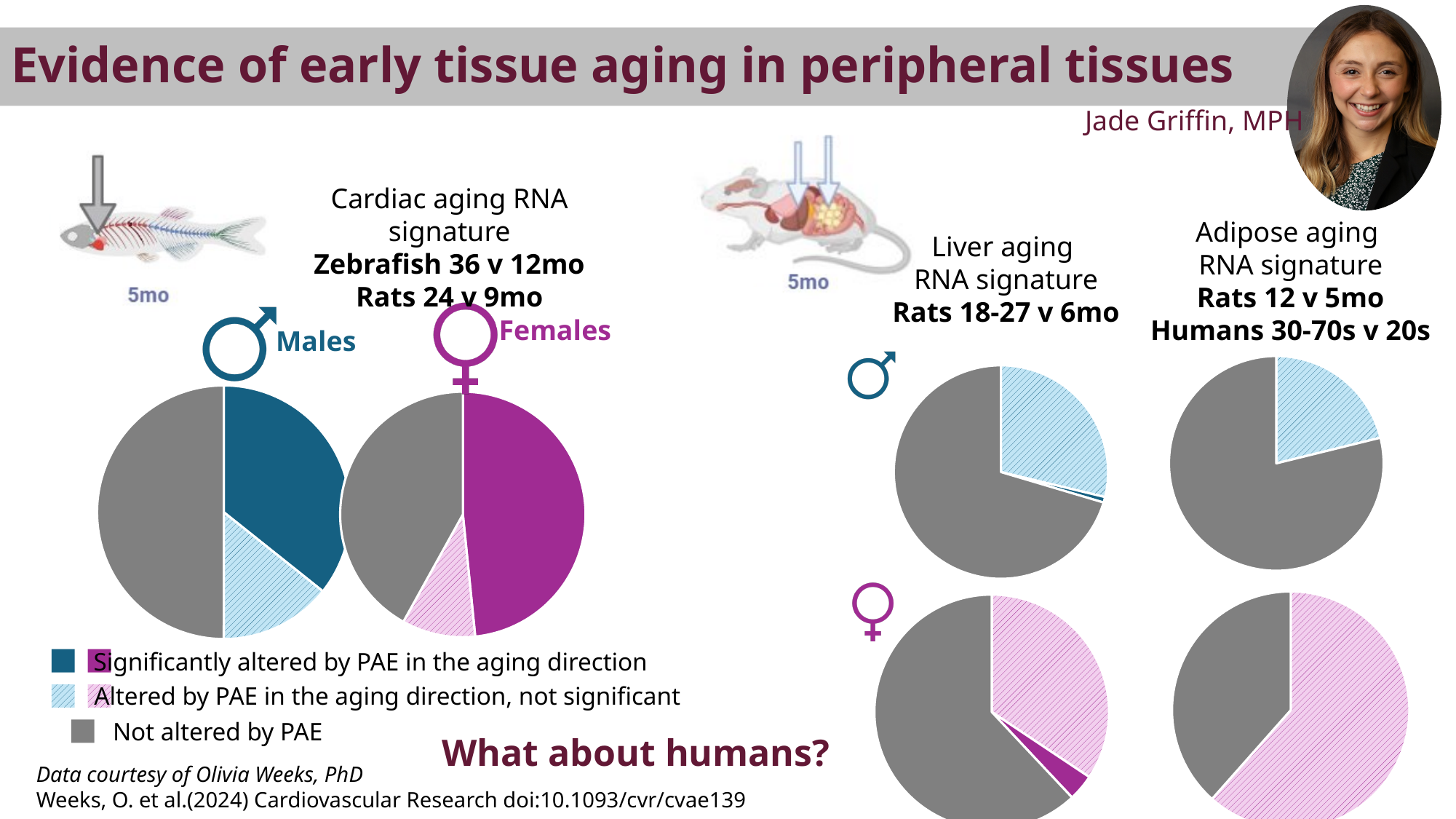
In the adipose aging RNA signature pie for females, which category has the largest slice? Altered by PAE in the aging direction, not significant In the cardiac aging RNA signature pie for males, which category has the largest slice? Not altered by PAE In the liver aging RNA signature pie for males, which category has the smallest slice? Significantly altered by PAE in the aging direction In the adipose aging RNA signature pie for males, is the 'Not altered by PAE' slice larger or smaller than the 'Altered by PAE in the aging direction, not significant' slice? Larger How many pie charts are shown on the slide? 6 What colour represents 'Not altered by PAE' in the pie charts? Gray In the liver aging RNA signature pie for females, which category has the largest slice? Not altered by PAE In the cardiac aging RNA signature pie for females, which category has the smallest slice? Altered by PAE in the aging direction, not significant What kind of chart is used to show the cardiac aging RNA signature for males? Pie chart How many categories does the legend list? 3 How many slices does the adipose aging RNA signature pie for males have? 2